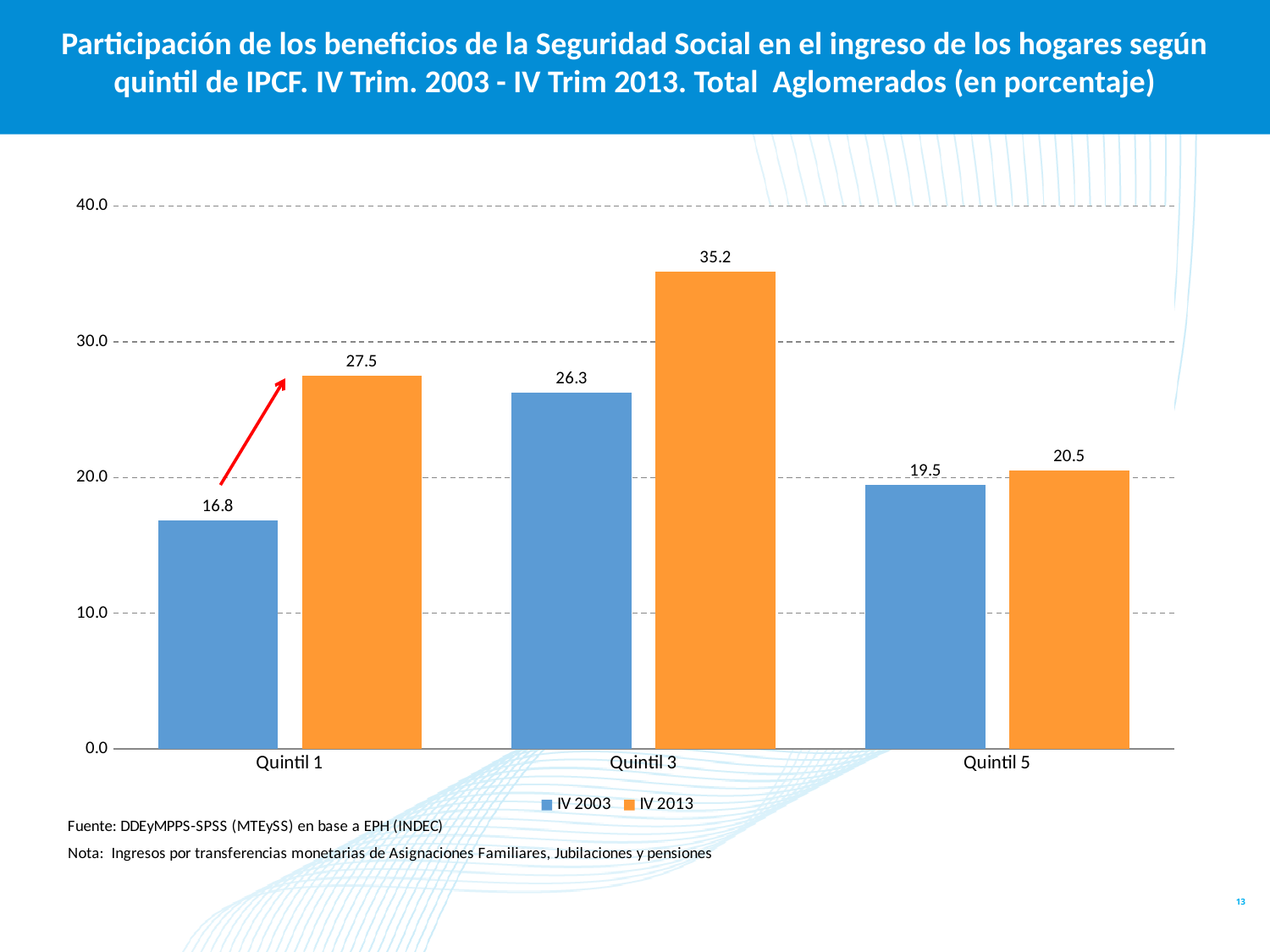
Which quintile has the lowest value in the IV 2003 series? Quintil 1 What kind of chart is shown on the slide? Bar chart Which quintile has the highest value in the IV 2013 series? Quintil 3 Which is larger for Quintil 5: the IV 2003 value or the IV 2013 value? IV 2013 Is the IV 2013 value for Quintil 3 greater or less than 30.0? greater How many series does the legend list? 2 What is the difference between the IV 2013 and IV 2003 values for Quintil 1? 10.7 What is the value for Quintil 1 in the IV 2003 series? 16.8 What is the value for Quintil 5 in the IV 2003 series? 19.5 What is the difference between the IV 2013 and IV 2003 values for Quintil 3? 8.9 What is the value for Quintil 3 in the IV 2013 series? 35.2 How many quintile categories are shown on the x axis? 3